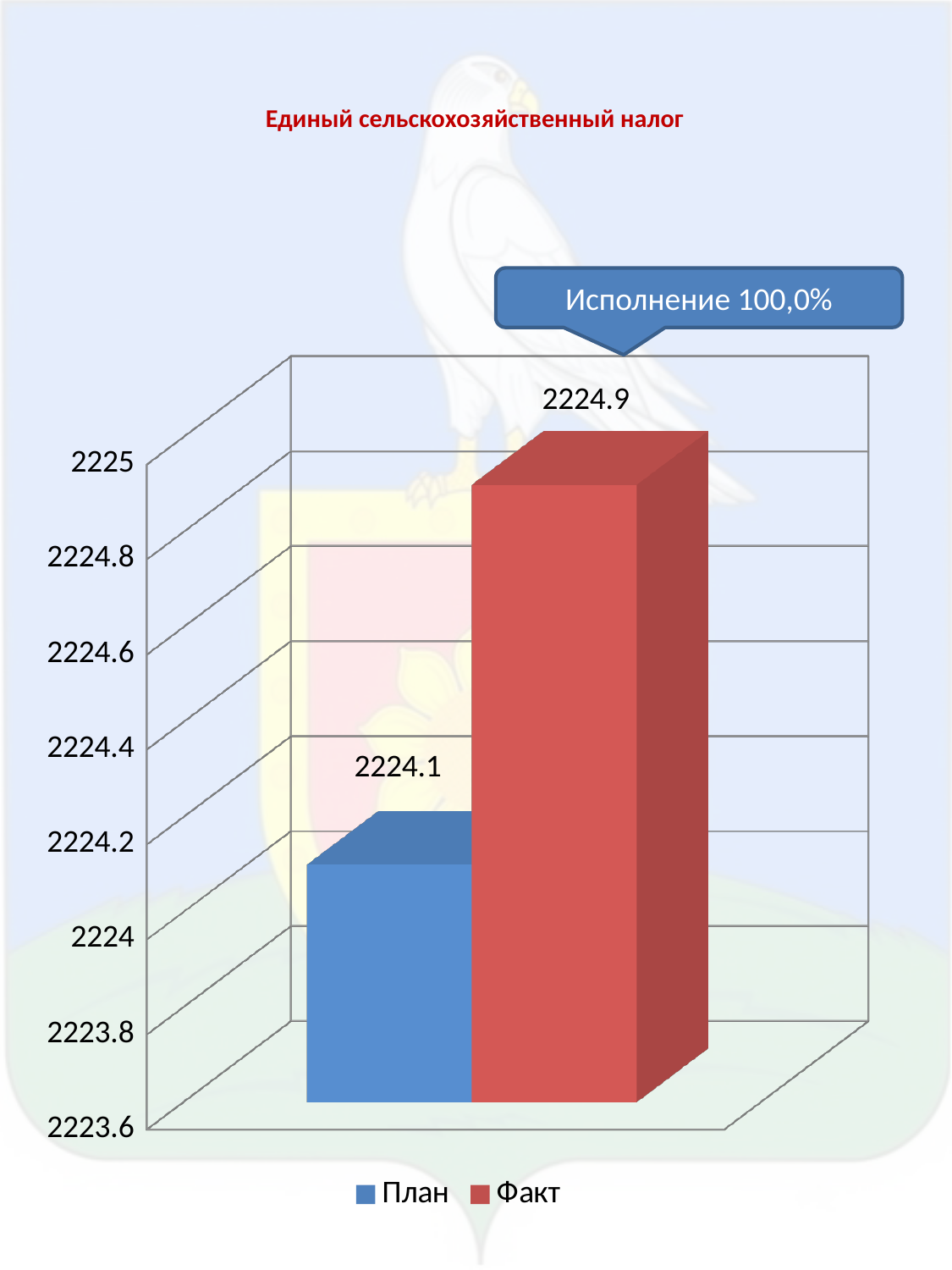
What is the value of План (Plan) on the chart? 2224.1 What kind of chart is shown on the slide? bar chart What is the difference between the Факт and План values? 0.8 Is the value for Факт greater or less than 2224.6? greater Is the value for План greater or less than 2224.4? less What is the value of Факт (Actual) on the chart? 2224.9 How many series does the legend list? 2 Which series has the higher value, План or Факт? Факт Which series has the lowest value on the chart? План What is the lowest value shown on the vertical axis? 2223.6 What execution percentage is shown in the callout on the slide? 100,0% What is the title of the chart? Единый сельскохозяйственный налог